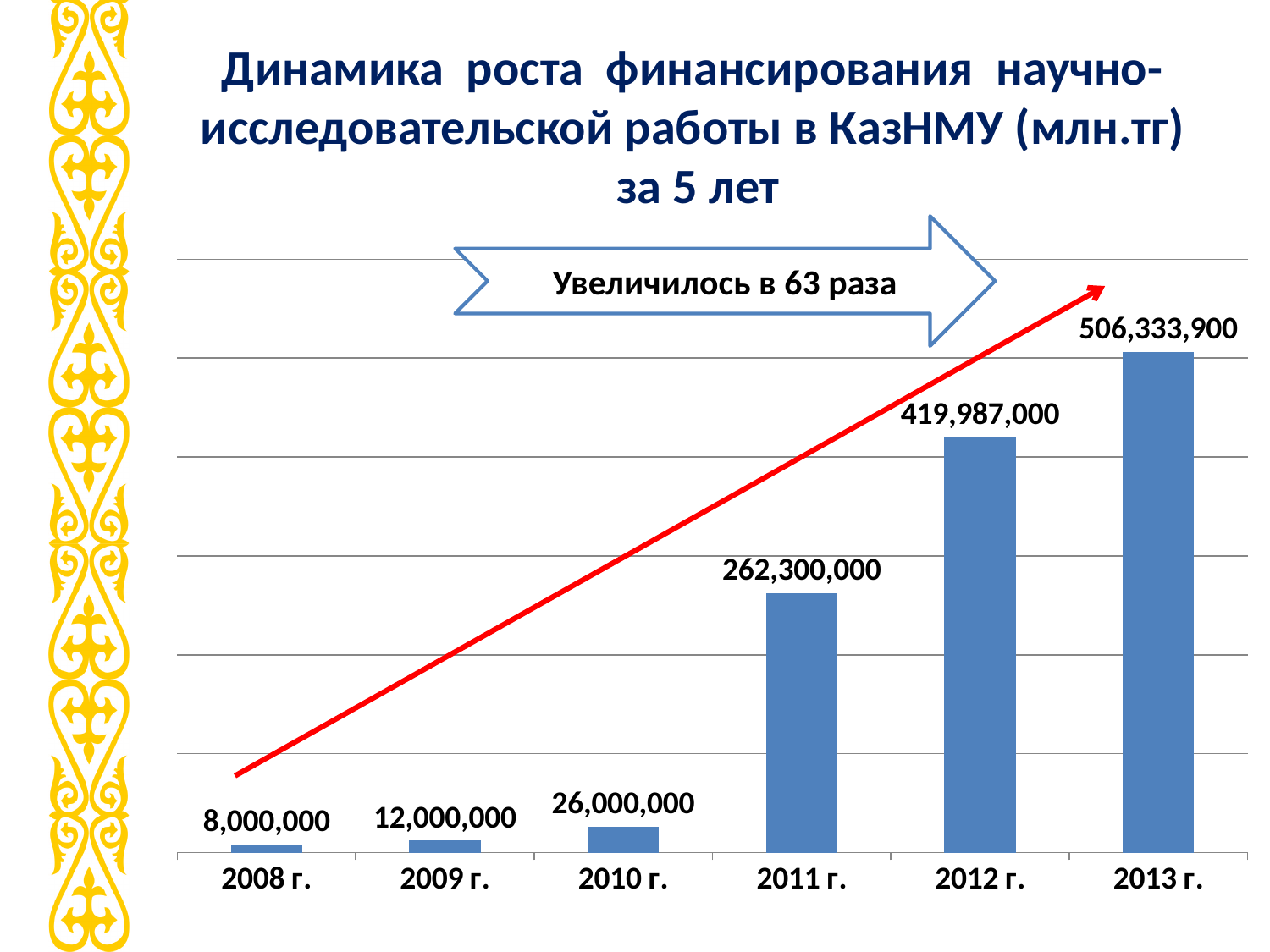
What is the value for 2012 г.? 419,987,000 What is the difference between the values for 2013 г. and 2012 г.? 86,346,900 Do the values rise or fall from 2008 г. to 2013 г.? rise What kind of chart is this? bar chart Which is larger, the value for 2011 г. or the value for 2012 г.? 2012 г. Which year has the highest value? 2013 г. What is the difference between the values for 2010 г. and 2009 г.? 14,000,000 Which year has the lowest value? 2008 г. What is the value for 2008 г.? 8,000,000 What is the value for 2011 г.? 262,300,000 What is the value for 2013 г.? 506,333,900 How many years are shown on the x axis? 6